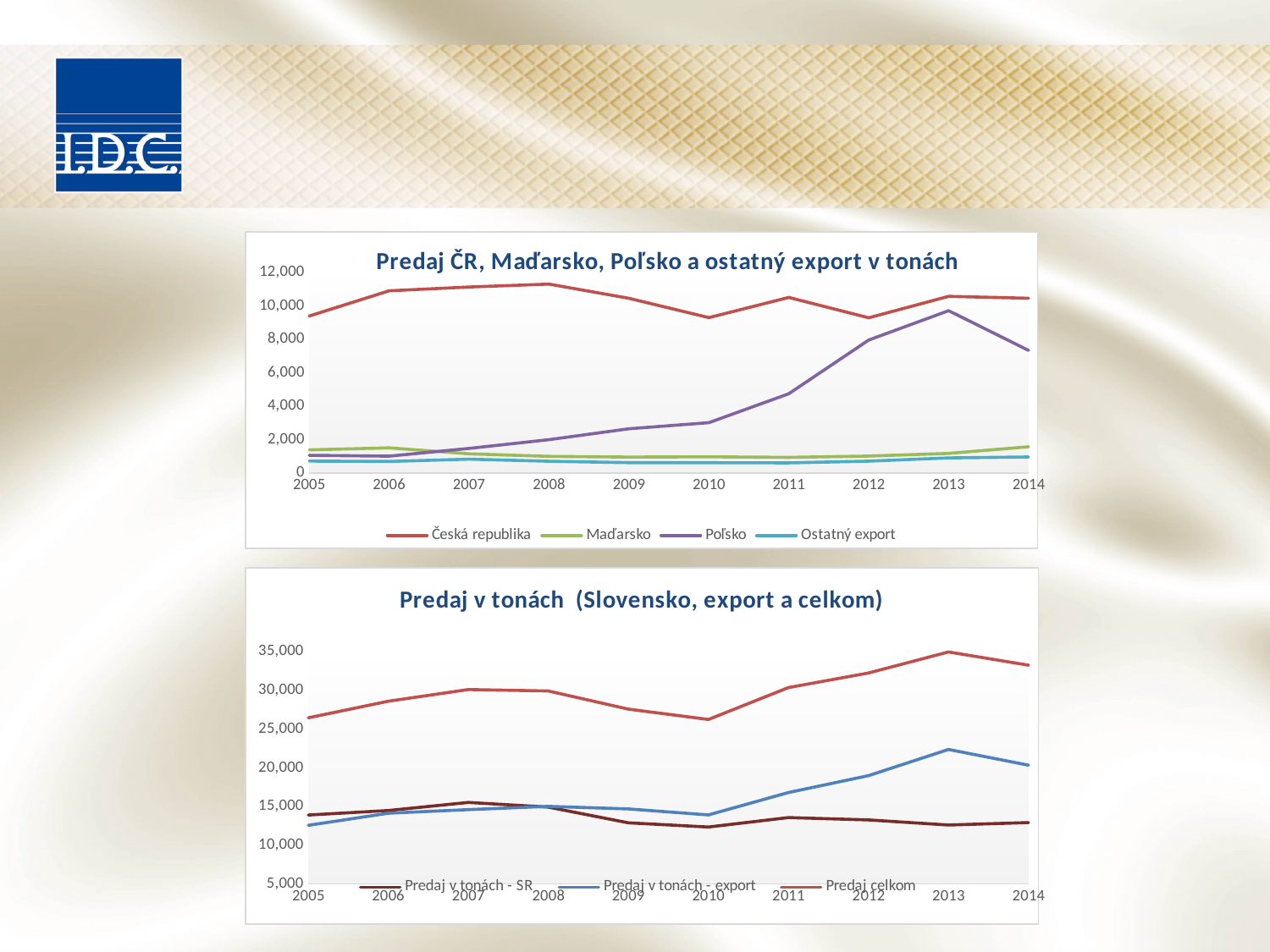
In the top chart, is the value for Poľsko in 2013 greater or less than 8,000? greater In the top chart, is the value for Poľsko in 2005 greater or less than 2,000? less How many series does the legend of the top chart list? 4 How many years are shown on the x axis of the top chart? 10 In the bottom chart, in which year is Predaj v tonách - export at its lowest? 2005 In the top chart, does the Poľsko line rise or fall between 2009 and 2013? rise What type of chart is the top chart titled 'Predaj ČR, Maďarsko, Poľsko a ostatný export v tonách'? line chart In the top chart, in which year does Poľsko reach its highest value? 2013 How many series does the legend of the bottom chart 'Predaj v tonách (Slovensko, export a celkom)' list? 3 In the top chart, which series is higher in 2014: Česká republika or Poľsko? Česká republika In the bottom chart, which series is higher in 2014: Predaj v tonách - SR or Predaj v tonách - export? Predaj v tonách - export In the bottom chart, is the value for Predaj celkom in 2013 greater or less than 30,000? greater